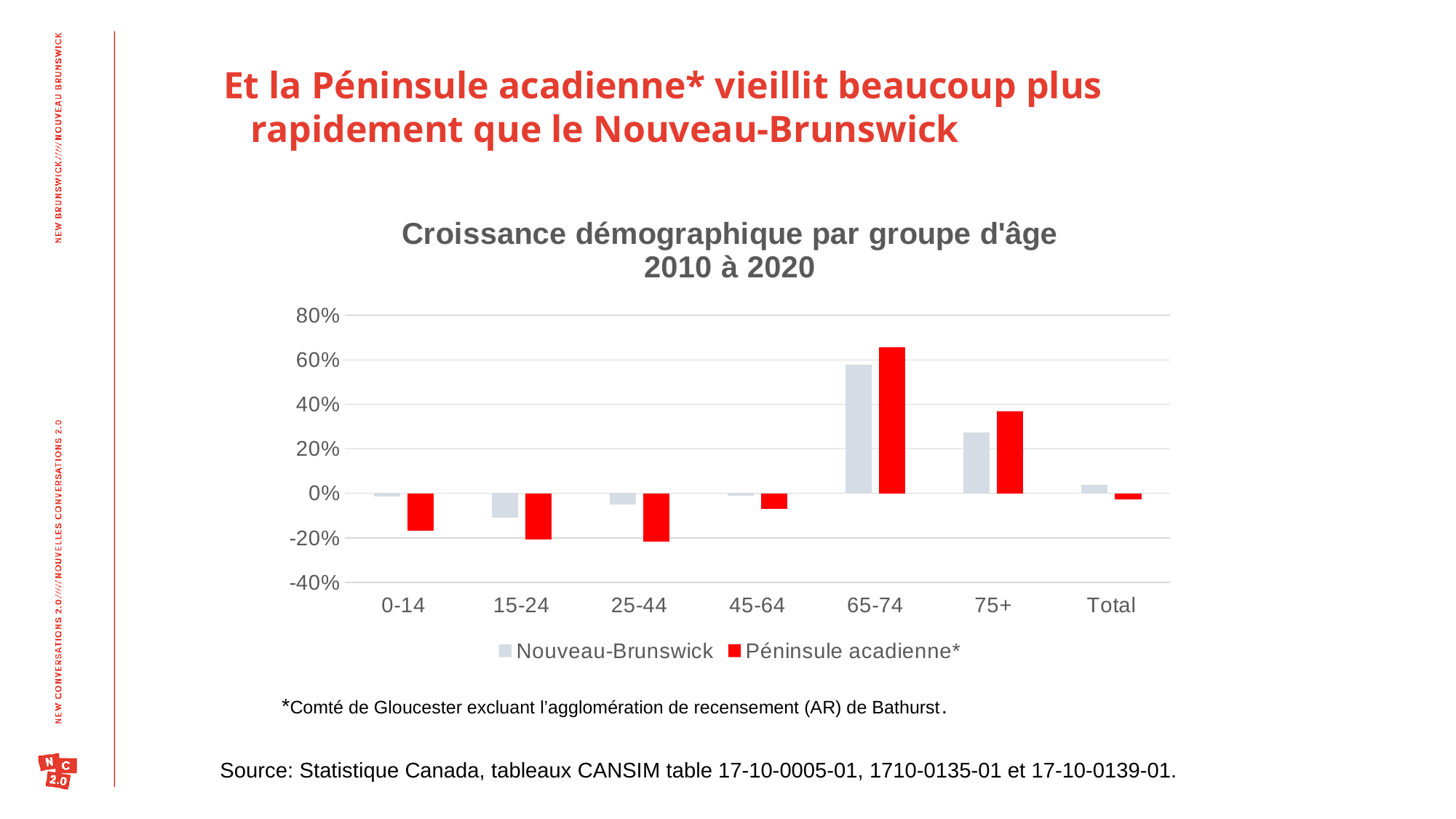
Which category has the highest value for Péninsule acadienne*? 65-74 Is the value for Nouveau-Brunswick in the 65-74 group greater or less than 40%? greater Which category has the highest value for Nouveau-Brunswick? 65-74 Which category has the lowest value for Nouveau-Brunswick? 15-24 For the Total category, which series has the larger value, Nouveau-Brunswick or Péninsule acadienne*? Nouveau-Brunswick For the 75+ group, which series has the larger value, Nouveau-Brunswick or Péninsule acadienne*? Péninsule acadienne* Is the value for Péninsule acadienne* in the 65-74 group greater or less than 60%? greater How many age-group categories are shown on the x axis, including Total? 7 What colour are the bars for Péninsule acadienne*? red What kind of chart is shown on the slide? bar chart How many series does the legend list? 2 Is the value for Péninsule acadienne* in the 75+ group greater or less than 20%? greater